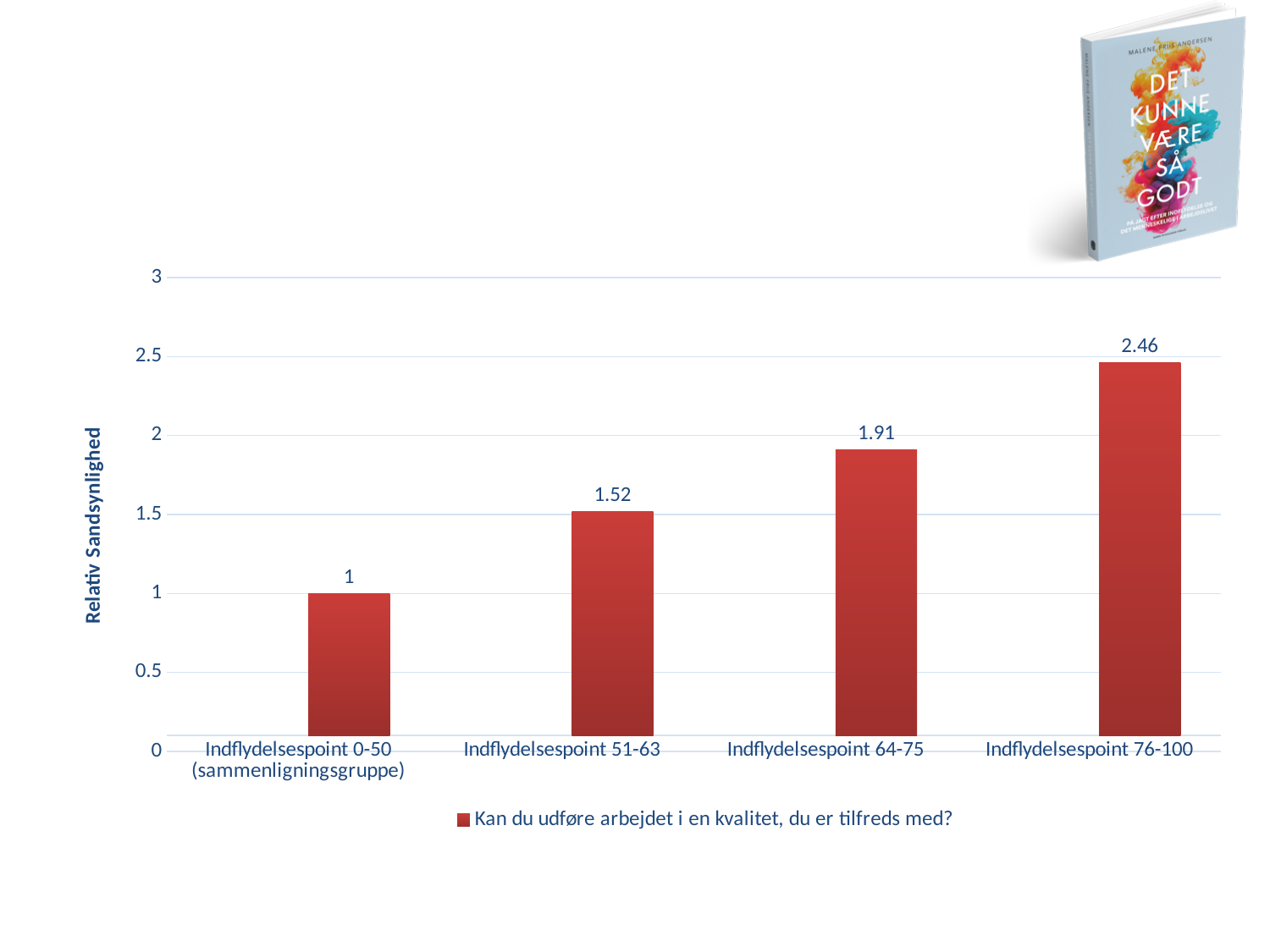
Do the values rise or fall from left to right along the x axis? rise What is the value for Indflydelsespoint 51-63? 1.52 Which category has the lowest value? Indflydelsespoint 0-50 (sammenligningsgruppe) Is the value for Indflydelsespoint 76-100 greater or less than 2? greater What is the difference between the values for Indflydelsespoint 76-100 and Indflydelsespoint 64-75? 0.55 Which is larger, the value for Indflydelsespoint 51-63 or Indflydelsespoint 64-75? Indflydelsespoint 64-75 What is the value for Indflydelsespoint 0-50 (sammenligningsgruppe)? 1 What kind of chart is shown? bar chart Which category has the highest value? Indflydelsespoint 76-100 What is the value for Indflydelsespoint 64-75? 1.91 How many categories are shown on the x axis? 4 What is the value for Indflydelsespoint 76-100? 2.46